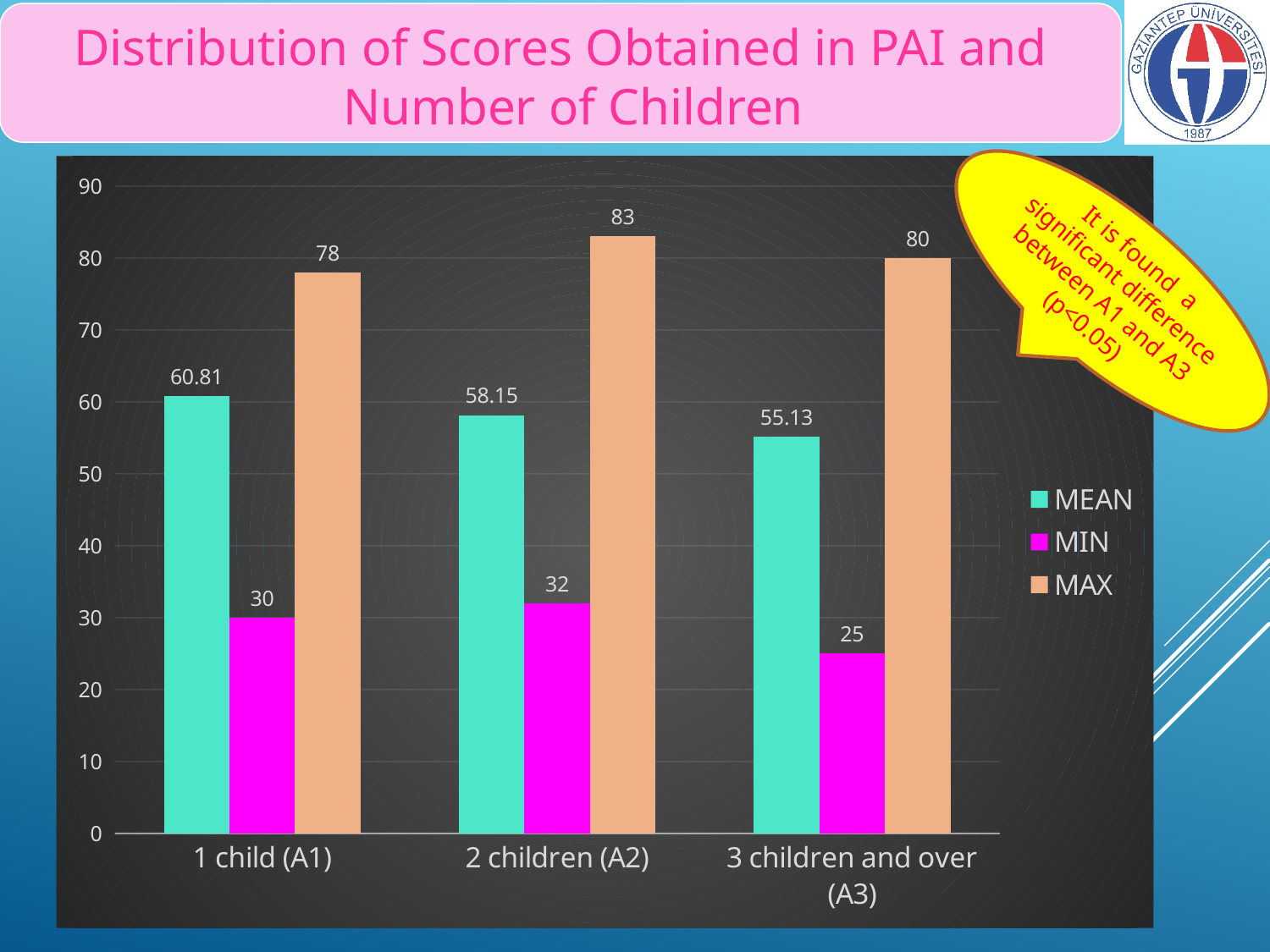
How many series does the legend list? 3 How many groups are shown on the x axis? 3 What is the MIN score for the 3 children and over (A3) group? 25 Do the MEAN scores rise or fall from 1 child (A1) to 3 children and over (A3)? Fall Is the MIN score for the 2 children (A2) group greater or less than 40? less What is the MAX score for the 2 children (A2) group? 83 What kind of chart is shown on the slide? Bar chart Which group has the lowest MIN score? 3 children and over (A3) Which group has the highest MEAN score? 1 child (A1) What is the difference between the MEAN scores of the 1 child (A1) and 3 children and over (A3) groups? 5.68 Which is larger, the MAX score for 1 child (A1) or the MAX score for 3 children and over (A3)? 3 children and over (A3) What is the MEAN score for the 1 child (A1) group? 60.81